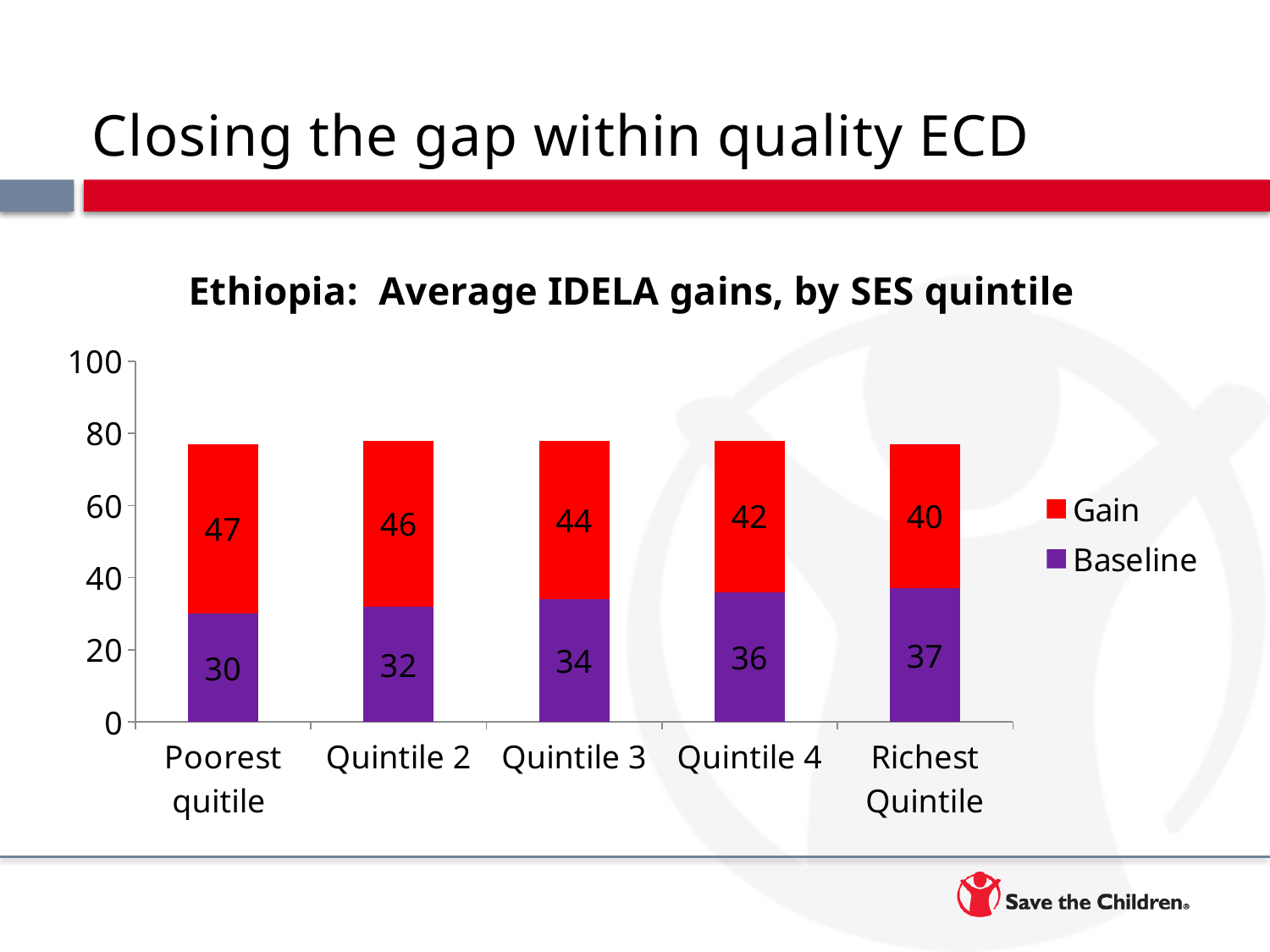
What is the total of the stacked bar for Quintile 2? 78 Which is larger: the Baseline for Quintile 4 or the Baseline for Quintile 2? Quintile 4 What is the difference between the Gain for the Poorest quitile and the Gain for the Richest Quintile? 7 What kind of chart is shown on the slide? Stacked bar chart What is the Baseline value for the Poorest quitile? 30 Which quintile has the lowest Baseline value? Poorest quitile Which quintile has the highest Gain value? Poorest quitile How many quintile categories are shown on the x axis? 5 Do the Baseline values rise or fall from the Poorest quitile to the Richest Quintile? Rise How many series does the legend list? 2 What is the Gain value for Quintile 3? 44 What is the Gain value for the Richest Quintile? 40